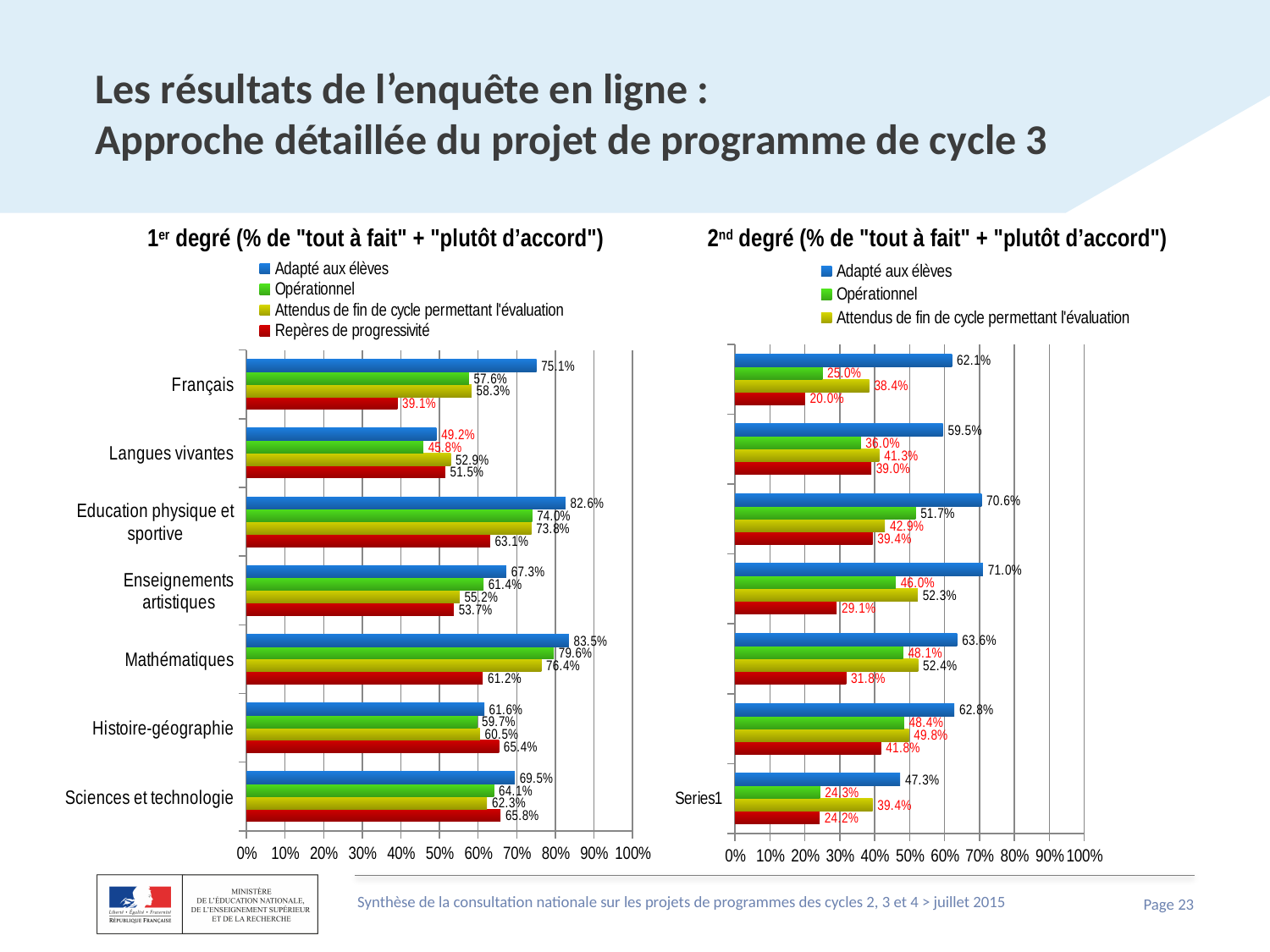
How many series does the legend of the right chart (2nd degré) list? 3 How many series does the legend of the left chart (1er degré) list? 4 In the left chart (1er degré), which category has the lowest value for Repères de progressivité? Français In the left chart (1er degré), what is the value of Repères de progressivité for Education physique et sportive? 63.1% In the left chart (1er degré), what is the value of Opérationnel for Mathématiques? 79.6% In the right chart (2nd degré), what is the highest value shown for Adapté aux élèves? 71.0% In the left chart (1er degré), what is the difference between Repères de progressivité and Adapté aux élèves for Histoire-géographie? 3.8 percentage points In the left chart (1er degré), which category has the highest value for Adapté aux élèves? Mathématiques In the left chart (1er degré), what is the value of Adapté aux élèves for Français? 75.1% What type of chart is the right chart (2nd degré)? Bar chart In the left chart (1er degré), for Sciences et technologie, which is larger: Adapté aux élèves or Repères de progressivité? Adapté aux élèves How many categories are shown in the left chart (1er degré)? 7